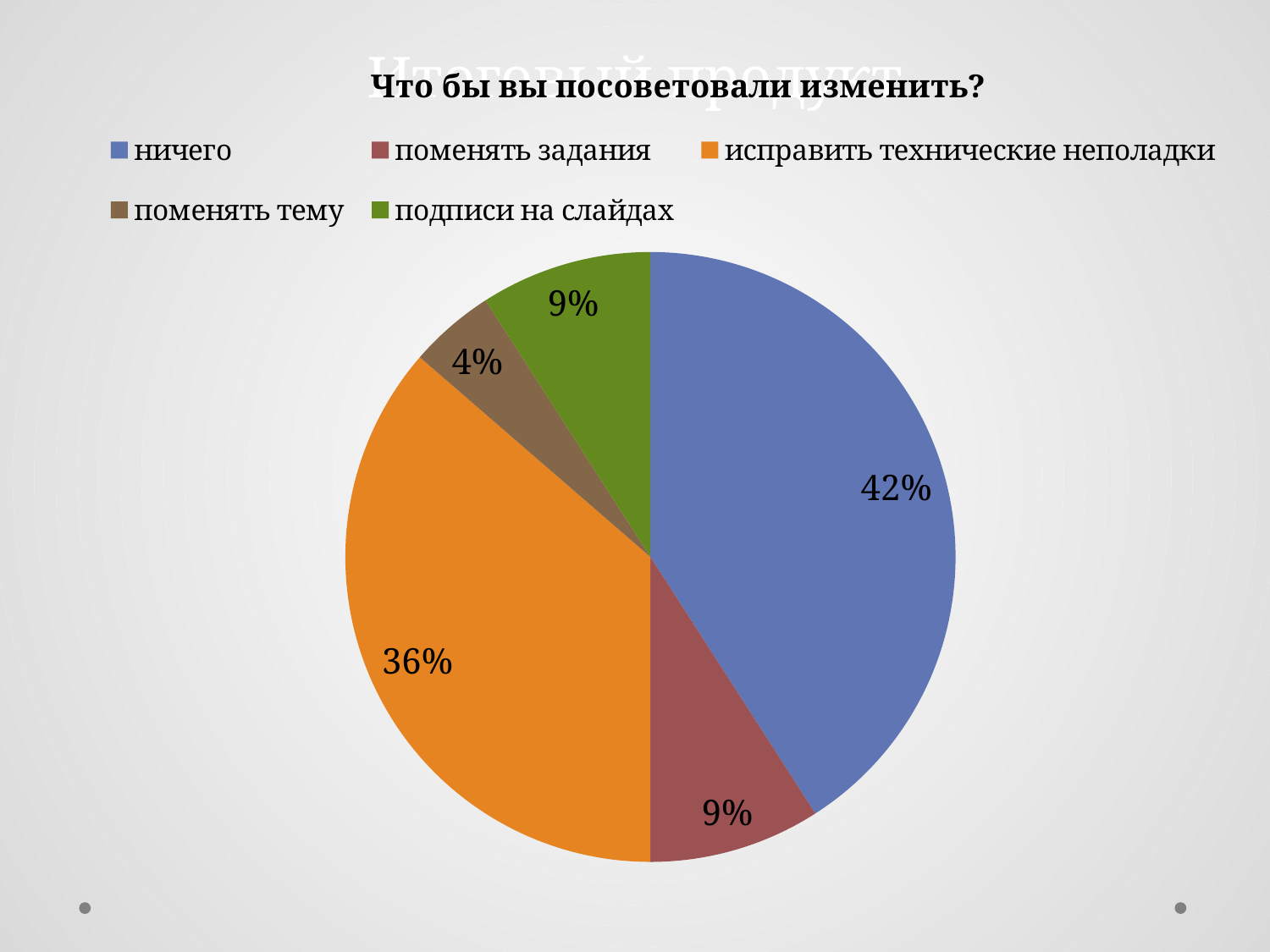
What colour is the slice for "исправить технические неполадки"? orange What share of the pie is labelled for "исправить технические неполадки"? 36% What share of the pie is labelled for "ничего"? 42% Which category has the largest slice of the pie? ничего What share of the pie is labelled for "поменять тему"? 4% Which category has the smallest slice of the pie? поменять тему What kind of chart is shown on the slide? pie chart What is the title of the chart? Что бы вы посоветовали изменить? What share of the pie is labelled for "подписи на слайдах"? 9% How many categories does the legend list? 5 Which is larger: the slice for "поменять задания" or the slice for "поменять тему"? поменять задания What is the difference in percentage points between "ничего" and "исправить технические неполадки"? 6